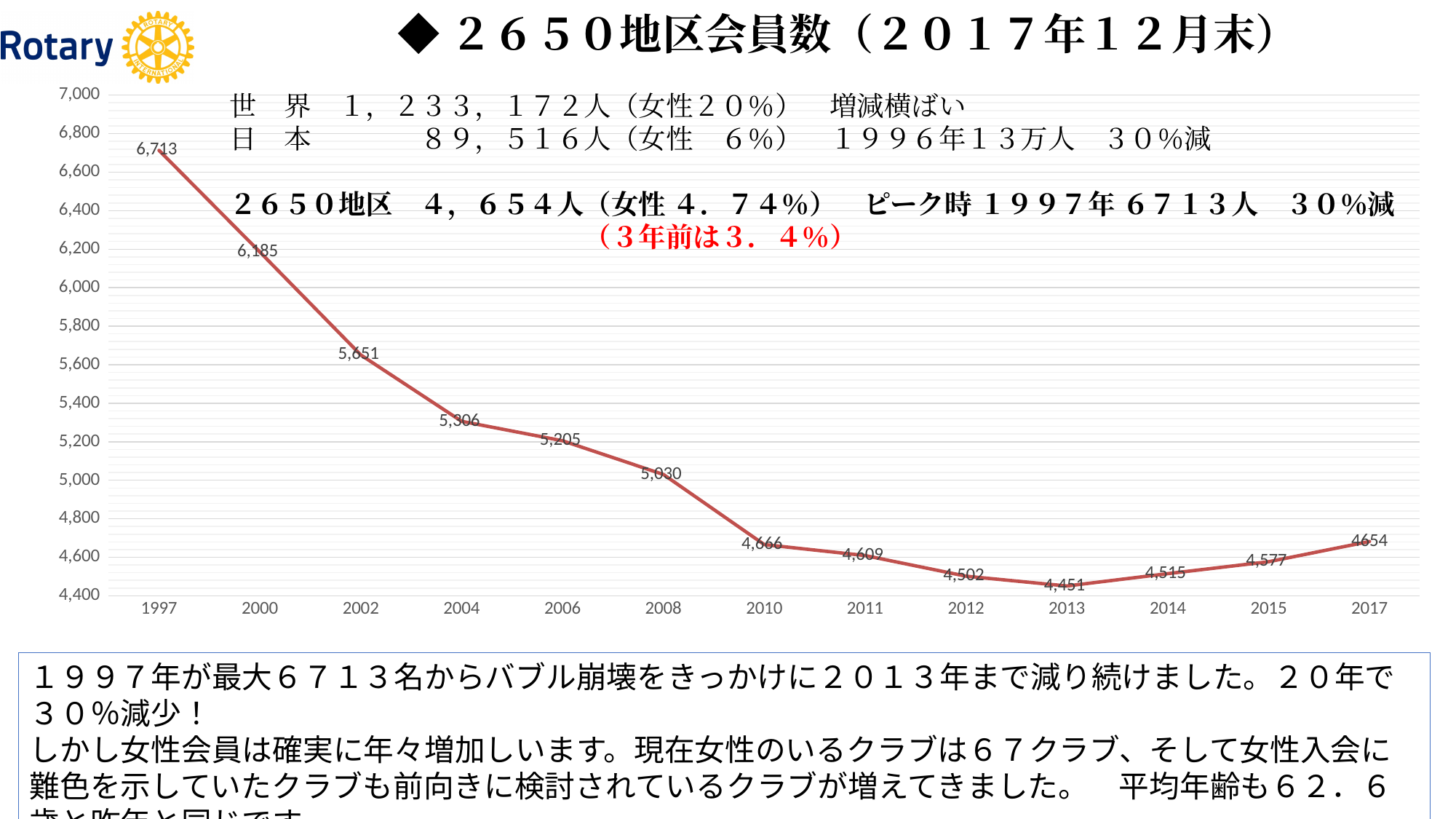
Which is larger, the value for 2010 or the value for 2011? 2010 Is the value for 2004 greater or less than 5,200? greater Does the plotted value rise or fall from 1997 to 2013? fall What is the membership value plotted for 1997? 6,713 What is the membership value plotted for 2008? 5,030 Which year has the lowest plotted value? 2013 Which year has the highest plotted value? 1997 What kind of chart is shown on the slide? line chart What is the membership value plotted for 2013? 4,451 How many data points are plotted on the line? 13 What is the difference between the values for 1997 and 2013? 2,262 What is the membership value plotted for 2017? 4654